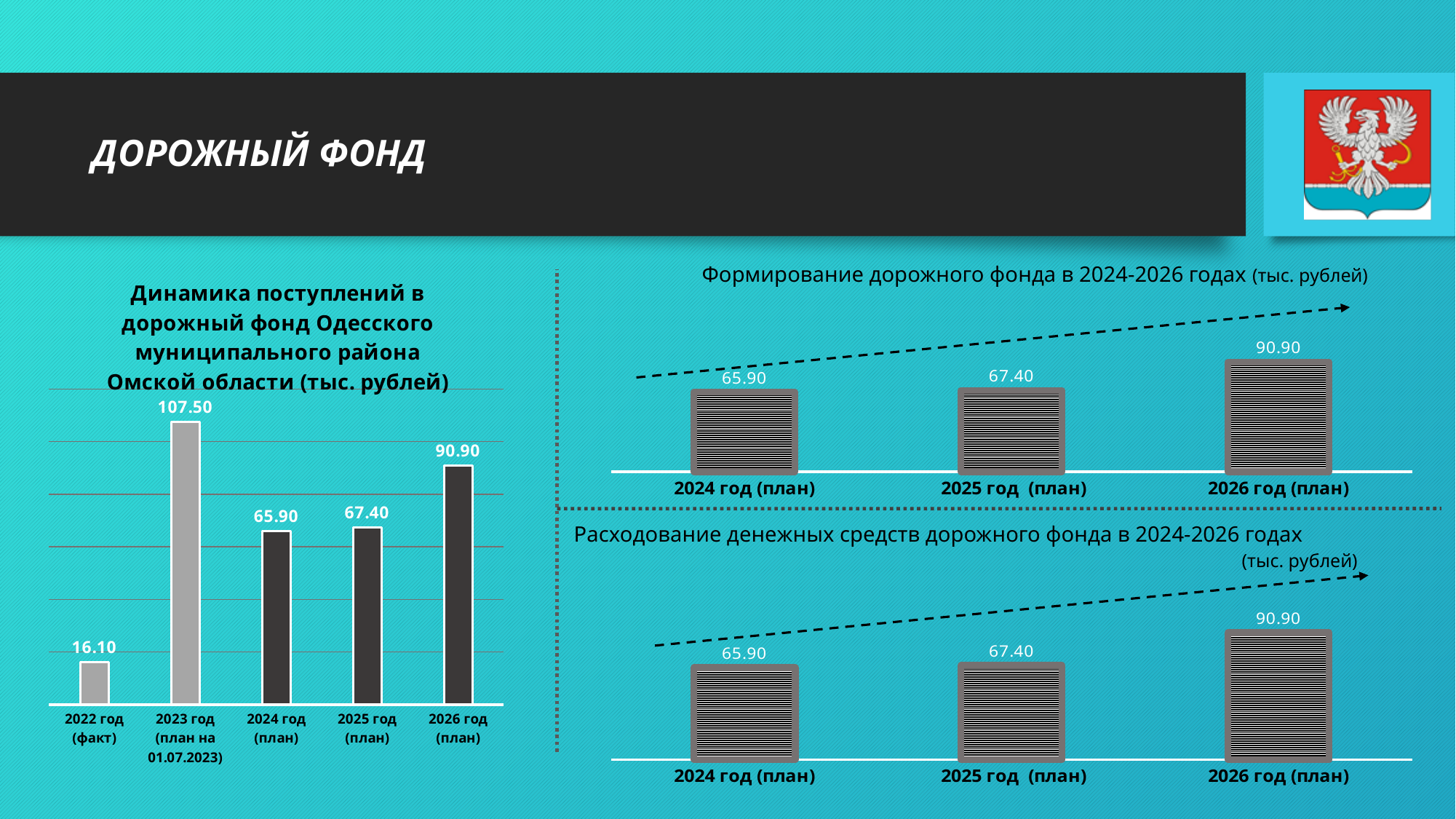
In the chart 'Динамика поступлений в дорожный фонд', which year has the highest value? 2023 год (план на 01.07.2023) In the chart 'Динамика поступлений в дорожный фонд', what is the value for 2023 год (план на 01.07.2023)? 107.50 In the chart 'Расходование денежных средств дорожного фонда в 2024-2026 годах', which is larger: the value for 2024 год (план) or 2025 год (план)? 2025 год (план) In the chart 'Формирование дорожного фонда в 2024-2026 годах', what is the value for 2025 год (план)? 67.40 In the chart 'Динамика поступлений в дорожный фонд', what is the difference between the values for 2023 год and 2022 год? 91.40 In the chart 'Динамика поступлений в дорожный фонд Одесского муниципального района Омской области', what is the value for 2022 год (факт)? 16.10 In the chart 'Динамика поступлений в дорожный фонд', which year has the lowest value? 2022 год (факт) In the chart 'Динамика поступлений в дорожный фонд', how many bars are plotted? 5 What type of chart is 'Динамика поступлений в дорожный фонд Одесского муниципального района Омской области'? Bar chart In the chart 'Расходование денежных средств дорожного фонда в 2024-2026 годах', what is the difference between the values for 2026 год (план) and 2024 год (план)? 25.00 In the chart 'Формирование дорожного фонда в 2024-2026 годах', do the values rise or fall from 2024 to 2026? Rise In the chart 'Расходование денежных средств дорожного фонда в 2024-2026 годах', what is the value for 2026 год (план)? 90.90